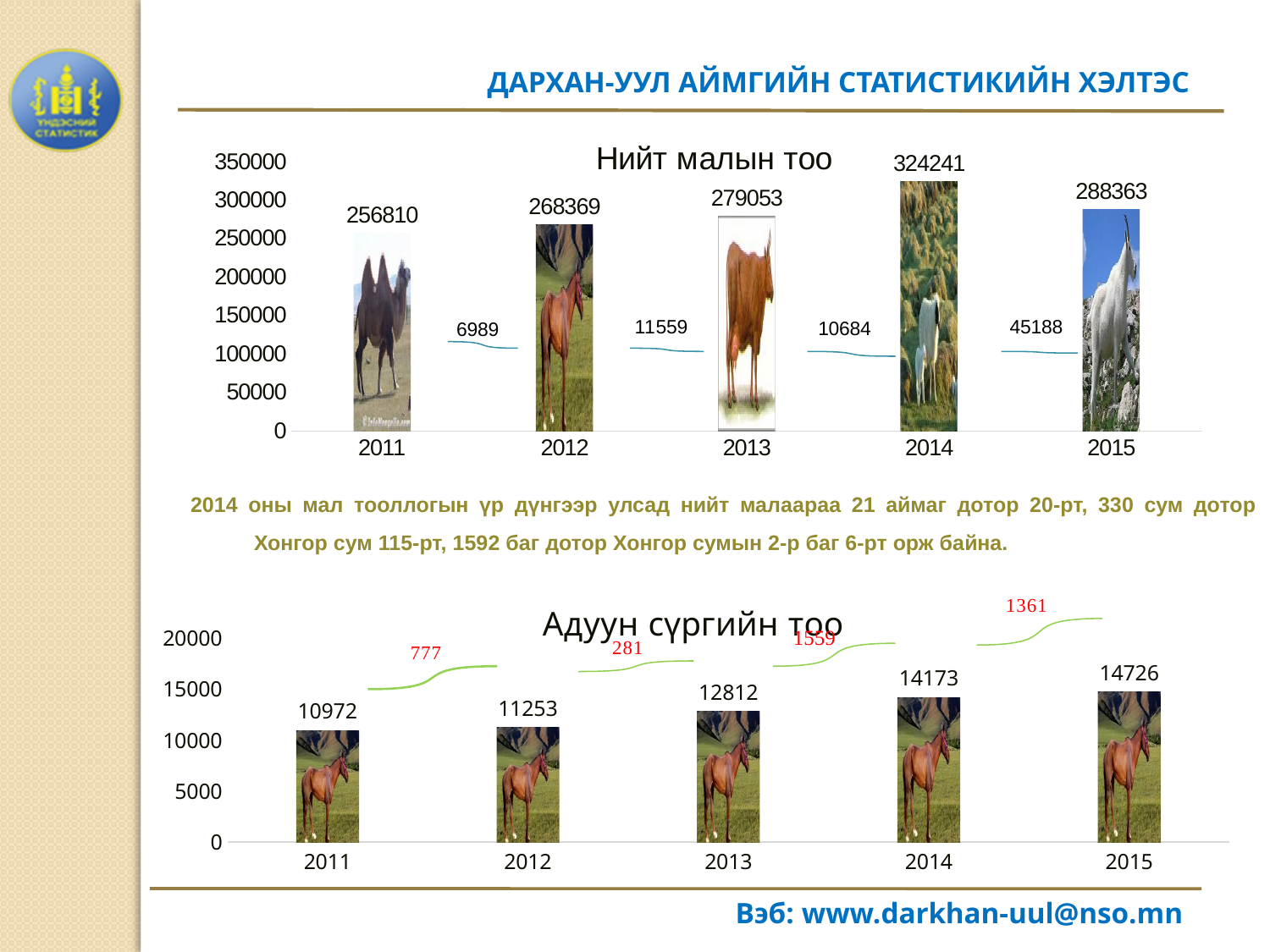
What kind of chart is the chart titled "Адуун сүргийн тоо"? bar chart In the chart titled "Адуун сүргийн тоо", what is the value for 2013? 12812 In the chart titled "Нийт малын тоо", what is the value for 2011? 256810 In the chart titled "Адуун сүргийн тоо", do the values rise or fall from 2011 to 2015? rise In the chart titled "Нийт малын тоо", what is the value for 2014? 324241 In the chart titled "Нийт малын тоо", which year has the highest value? 2014 In the chart titled "Нийт малын тоо", which year has the lowest value? 2011 In the chart titled "Адуун сүргийн тоо", what is the difference between the values for 2012 and 2011? 281 In the chart titled "Нийт малын тоо", what is the difference between the values for 2014 and 2015? 35878 In the chart titled "Адуун сүргийн тоо", which year has the lowest value? 2011 In the chart titled "Нийт малын тоо", how many years are shown on the x axis? 5 In the chart titled "Адуун сүргийн тоо", what is the value for 2015? 14726